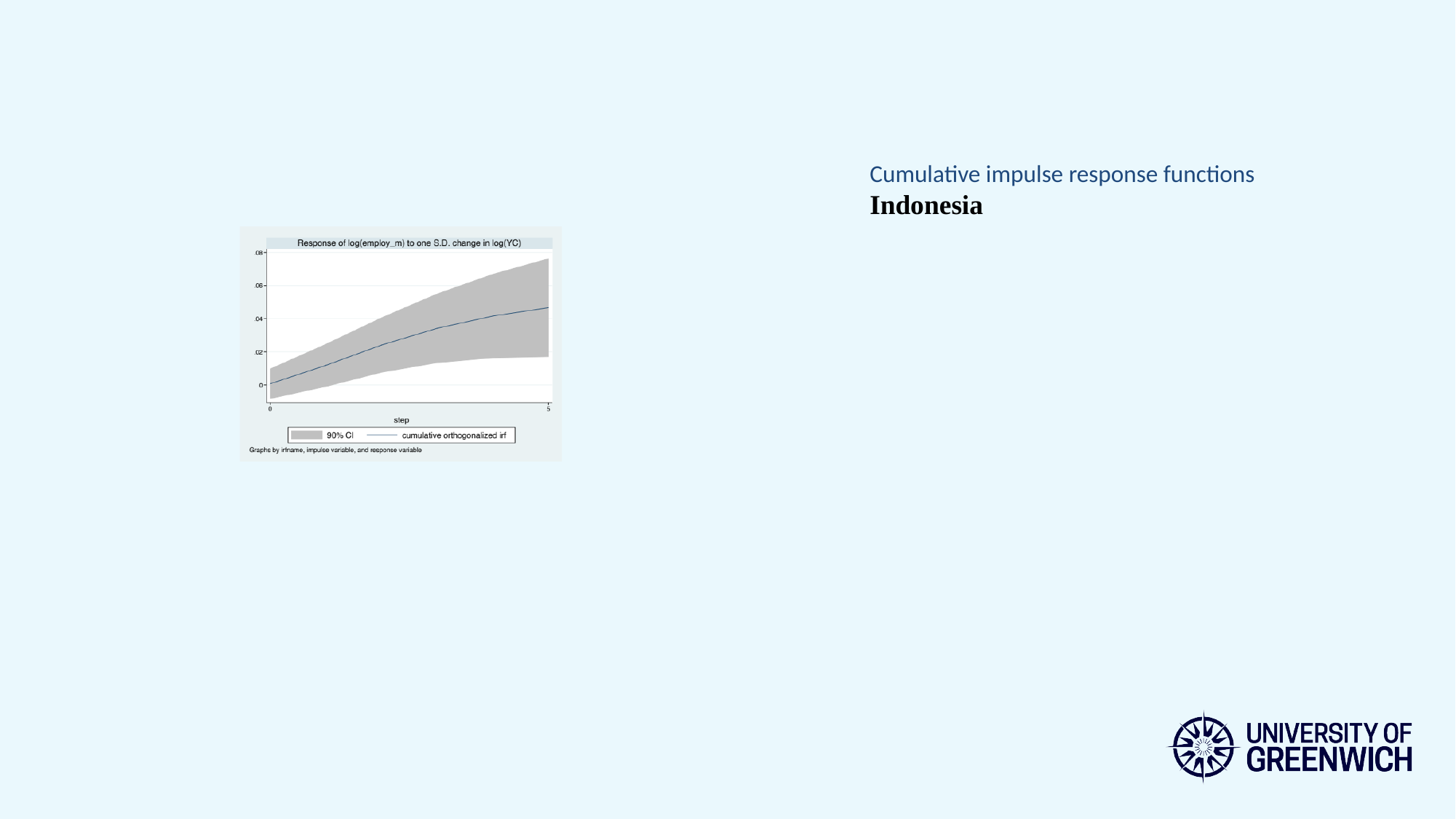
Does the cumulative orthogonalized irf line rise or fall as step increases from 0 to 5? Rise What kind of chart is shown on the slide? Line chart Which is larger, the cumulative orthogonalized irf at step 5 or at step 0? Step 5 Is the value of the cumulative orthogonalized irf at step 0 greater or less than .02? less What confidence level does the shaded band in the chart represent? 90% CI Is the value of the cumulative orthogonalized irf at step 5 greater or less than .04? greater What is the label on the x axis of the chart? step What is the title of the chart? Response of log(employ_m) to one S.D. change in log(YC) What is the highest tick value shown on the y axis of the chart? .08 Is the value of the cumulative orthogonalized irf at step 5 greater or less than .06? less How many entries does the chart legend list? 2